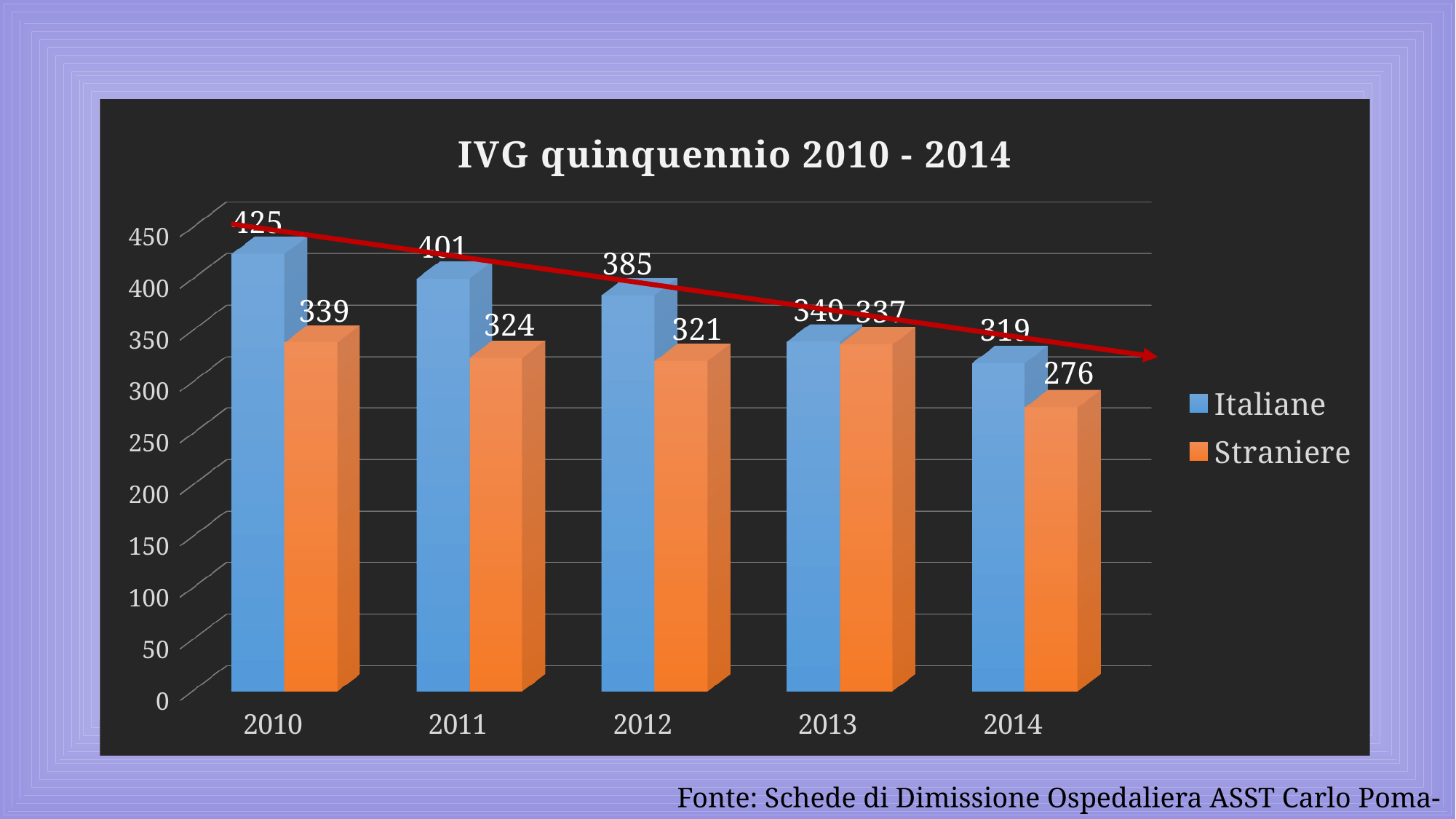
In which year is the Italiane value highest? 2010 Which is larger in 2012, the Italiane value or the Straniere value? Italiane In which year is the Straniere value lowest? 2014 How many years are shown on the x axis? 5 What is the value for Italiane in 2011? 401 What is the value for Italiane in 2012? 385 Is the Straniere value for 2010 greater or less than 300? greater How many series does the legend list? 2 What is the value for Straniere in 2011? 324 What is the value for Straniere in 2014? 276 What is the difference between the Italiane and Straniere values in 2014? 43 Do the Italiane values rise or fall from 2010 to 2014? fall